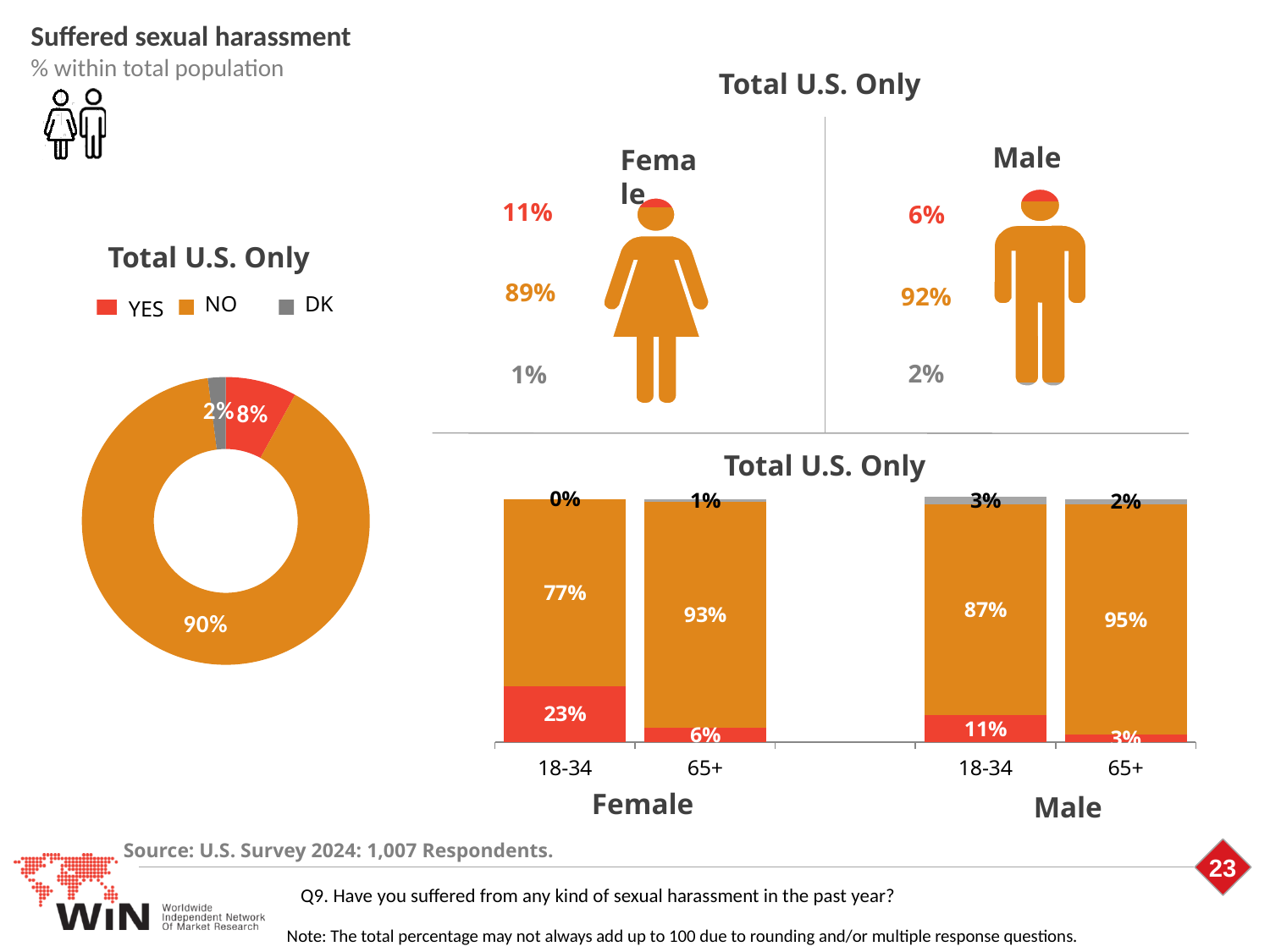
In the stacked bar chart at the bottom right, what is the YES value for Female 18-34? 23% In the stacked bar chart at the bottom right, what is the difference between the YES value for Female 18-34 and the YES value for Female 65+? 17 percentage points In the gender infographic at the top right, which group has the larger YES percentage, Female or Male? Female In the stacked bar chart at the bottom right, which group has the highest YES value? Female 18-34 In the donut chart on the left, what percentage answered YES? 8% How many bars are shown in the stacked bar chart at the bottom right? 4 In the stacked bar chart at the bottom right, what is the NO value for Male 65+? 95% What kind of chart is the chart on the left of the slide? Donut (pie) chart In the stacked bar chart at the bottom right, what is the DK value for Male 18-34? 3% How many entries does the legend of the donut chart on the left list? 3 In the gender infographic at the top right, what percentage of females answered YES? 11% In the donut chart on the left titled 'Total U.S. Only', what percentage answered NO? 90%